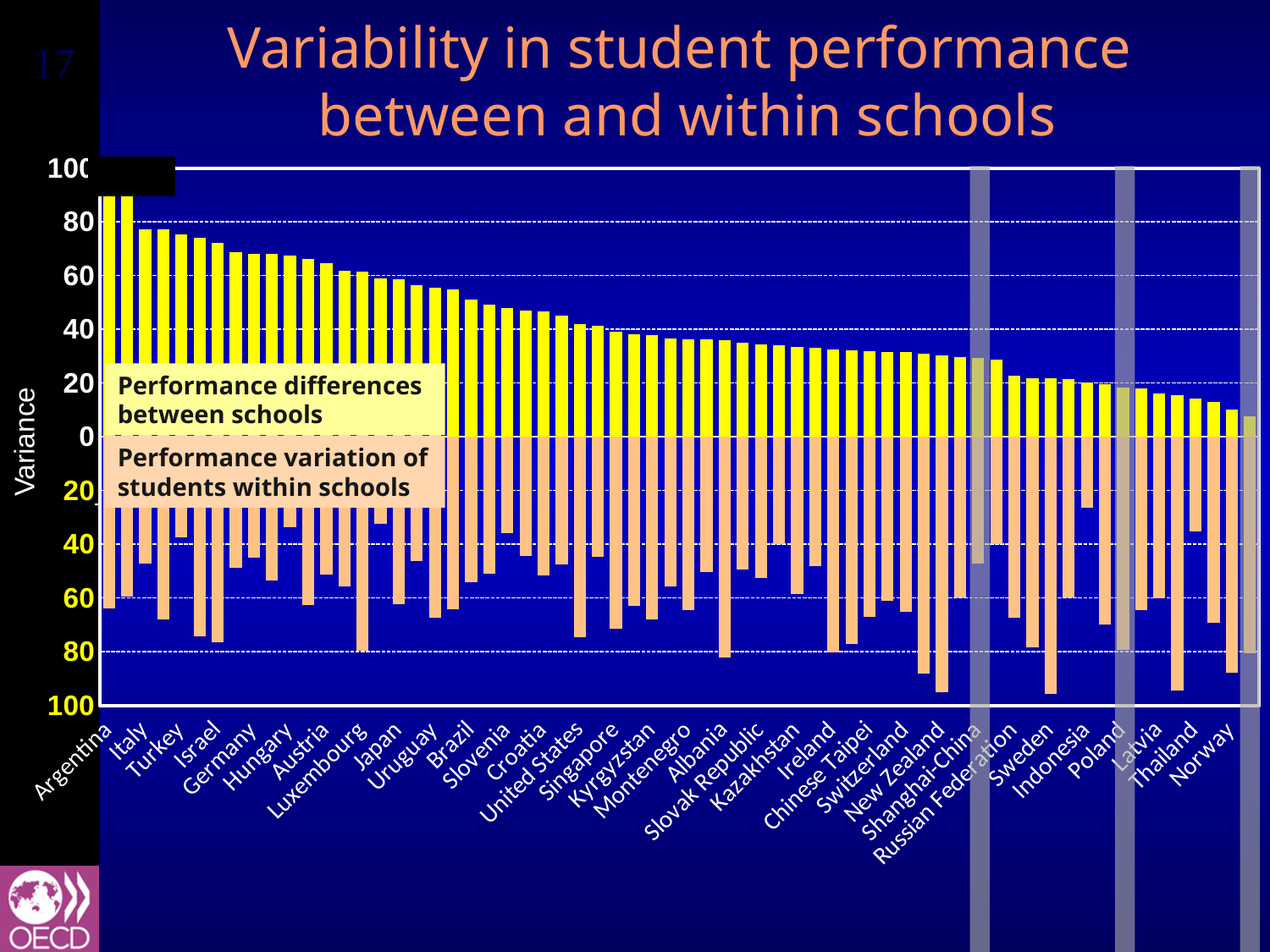
How many series does the chart show? 2 What is the label on the vertical axis of the chart? Variance Which country has the highest value for performance differences between schools? Argentina Do the values for performance differences between schools rise or fall from left to right along the x axis? fall Which has a larger value for performance differences between schools, Argentina or Norway? Argentina What is the title of the chart? Variability in student performance between and within schools Is the value for performance differences between schools for Argentina greater or less than 80? greater What kind of chart is shown on the slide? bar chart Is the value for performance differences between schools for Norway greater or less than 20? less